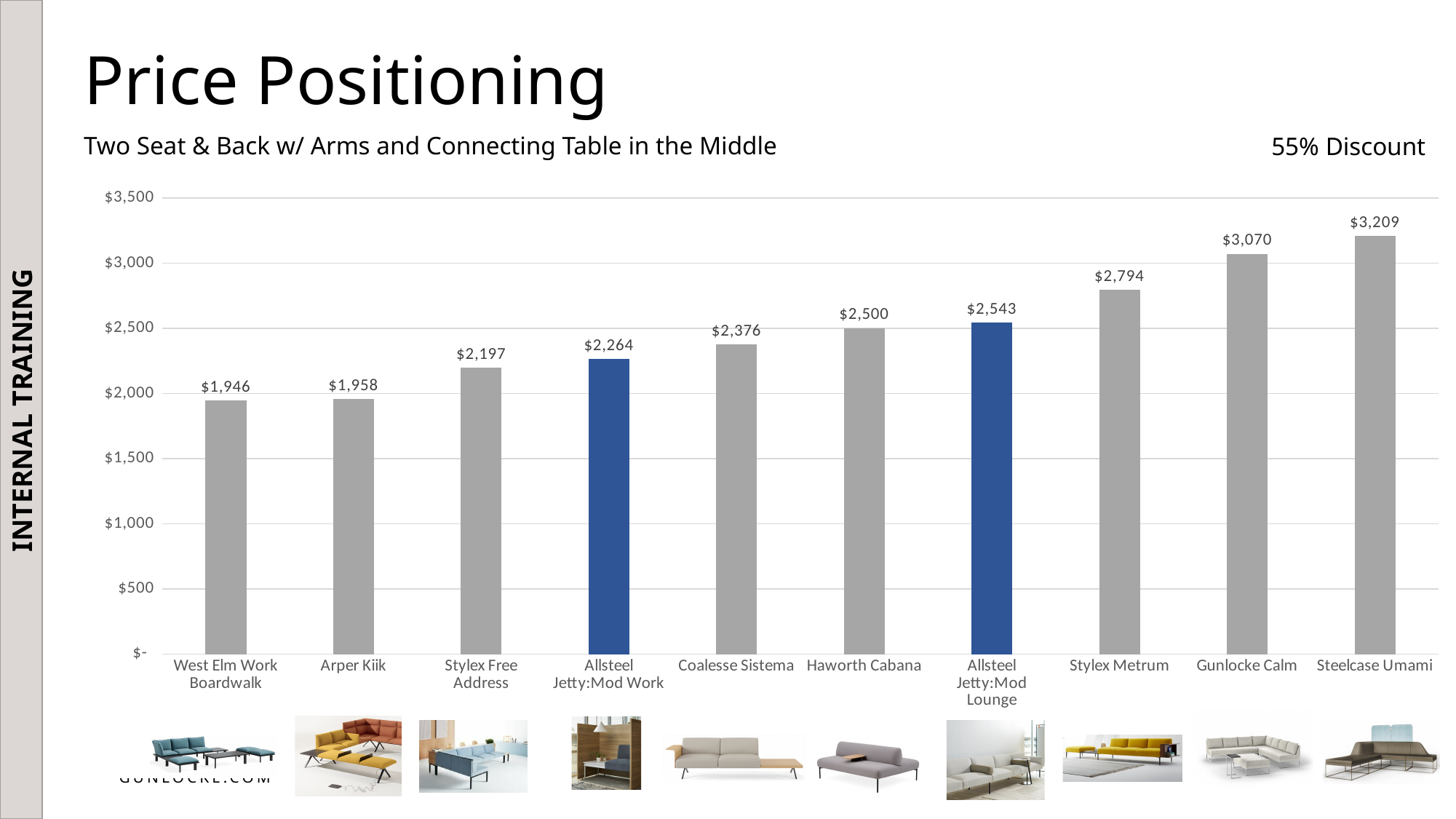
Is the value for Arper Kiik greater or less than $2,000? less What is the value for Allsteel Jetty:Mod Lounge? $2,543 How many products are shown in the chart? 10 Which product has the highest price? Steelcase Umami What is the value for Haworth Cabana? $2,500 What kind of chart is shown? bar chart Which two bars are highlighted in blue? Allsteel Jetty:Mod Work and Allsteel Jetty:Mod Lounge Which is higher, Stylex Metrum or Coalesse Sistema? Stylex Metrum Which product has the lowest price? West Elm Work Boardwalk What is the value for Stylex Free Address? $2,197 What is the difference between Steelcase Umami and Gunlocke Calm? $139 What is the difference between Allsteel Jetty:Mod Lounge and Allsteel Jetty:Mod Work? $279